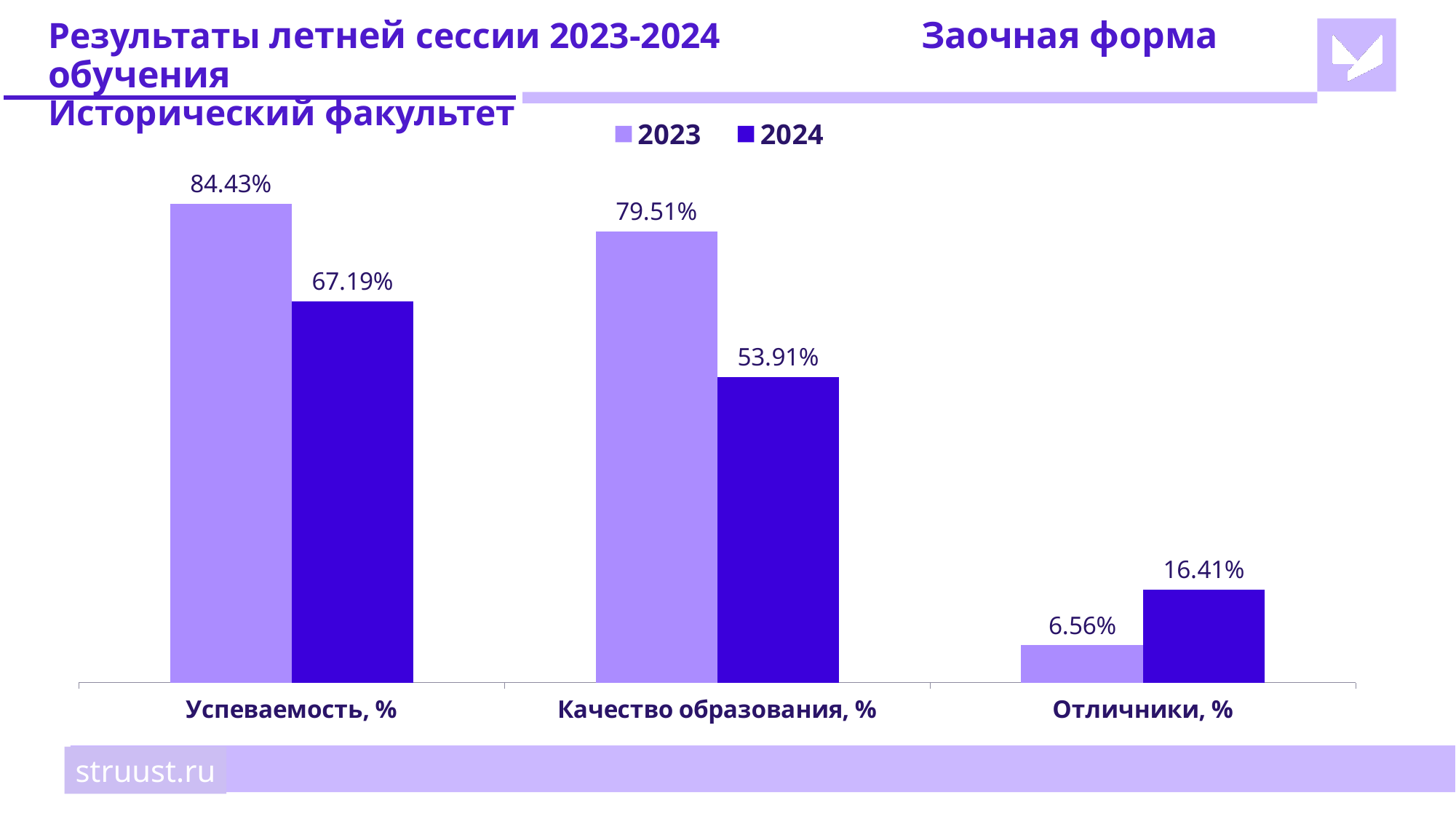
Which category has the lowest 2024 value? Отличники, % What is the 2024 value for Качество образования, %? 53.91% For Отличники, %, which year has the larger value, 2023 or 2024? 2024 What is the 2024 value for Отличники, %? 16.41% What is the difference between the 2023 and 2024 values for Качество образования, %? 25.60% What kind of chart is shown on the slide? Bar chart How many categories are shown on the x axis? 3 What is the difference between the 2023 and 2024 values for Успеваемость, %? 17.24% How many series does the legend list? 2 What is the 2023 value for Отличники, %? 6.56% What is the 2023 value for Успеваемость, %? 84.43% Which category has the highest 2023 value? Успеваемость, %